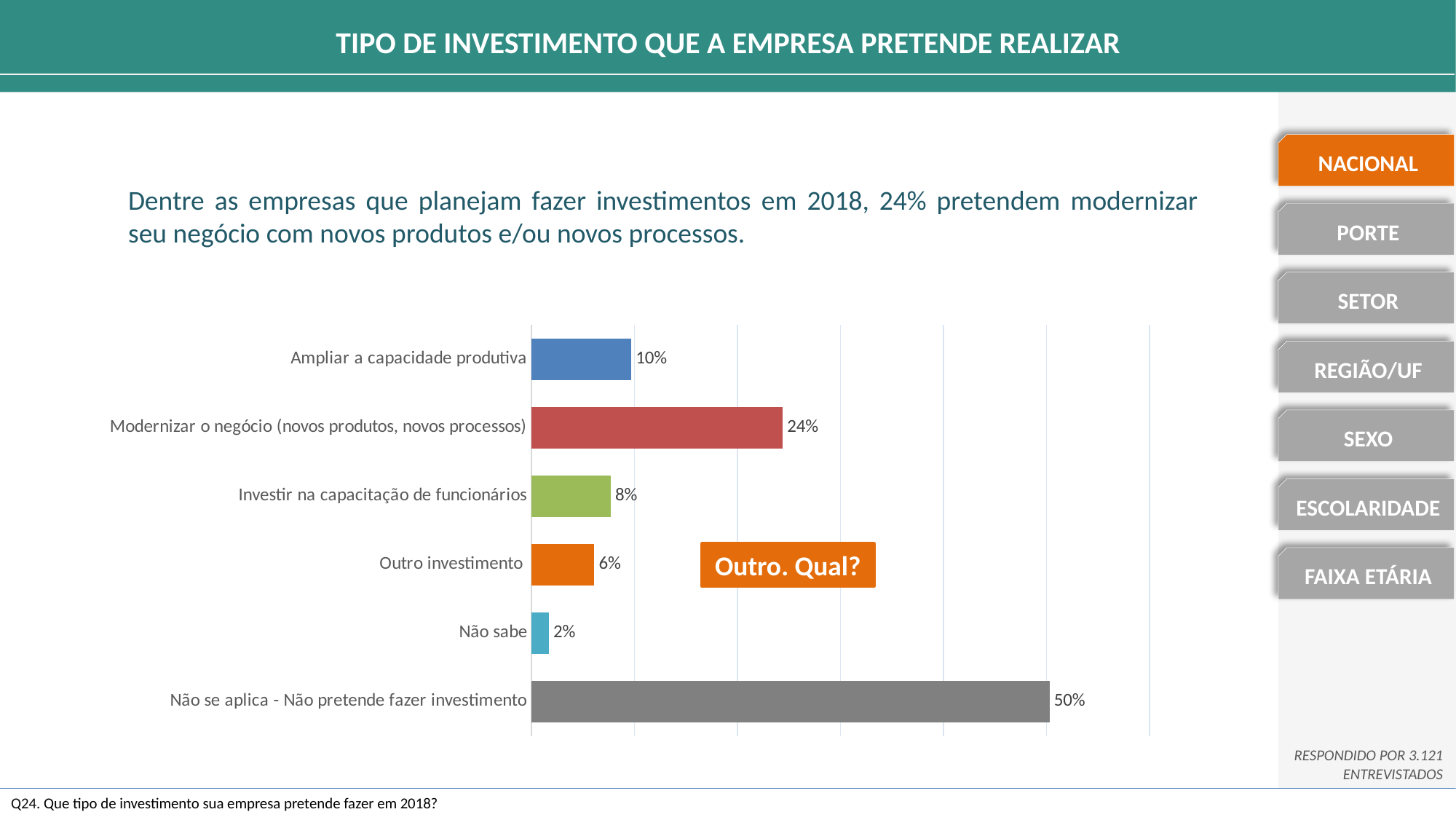
What is the difference between "Investir na capacitação de funcionários" and "Outro investimento"? 2% What is the value for "Não sabe"? 2% What is the title of the slide containing the chart? TIPO DE INVESTIMENTO QUE A EMPRESA PRETENDE REALIZAR What kind of chart is shown on the slide? Bar chart Which category has the highest value? Não se aplica - Não pretende fazer investimento Which is larger: "Ampliar a capacidade produtiva" or "Outro investimento"? Ampliar a capacidade produtiva How many categories are shown in the chart? 6 What is the difference between "Não se aplica - Não pretende fazer investimento" and "Modernizar o negócio (novos produtos, novos processos)"? 26% Which category has the lowest value? Não sabe What is the value for "Modernizar o negócio (novos produtos, novos processos)"? 24% What is the value for "Investir na capacitação de funcionários"? 8% What is the value for "Ampliar a capacidade produtiva"? 10%